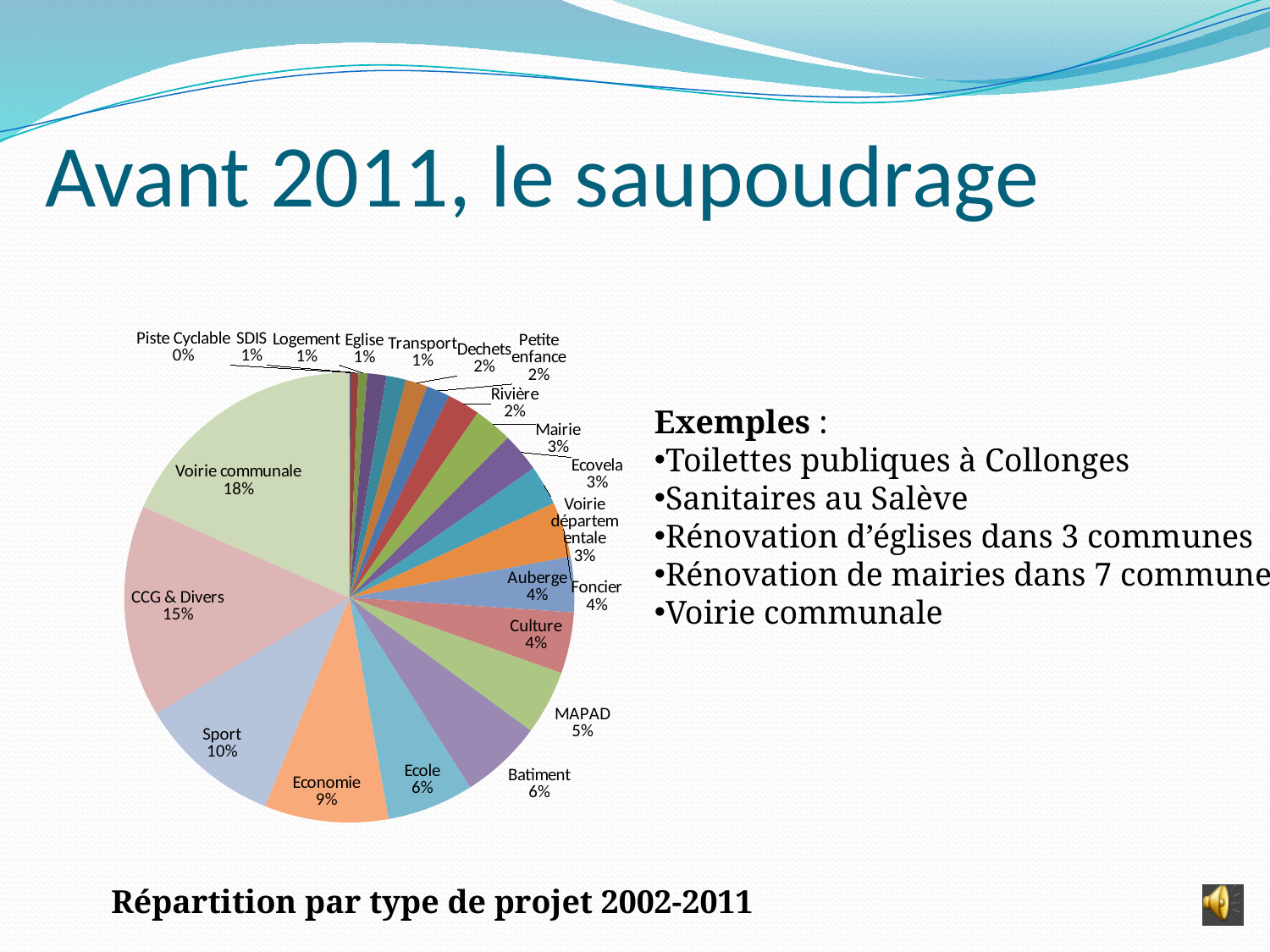
What percentage is shown for Sport? 10% What is the difference in percentage points between Voirie communale and CCG & Divers? 3 What percentage is shown for Economie? 9% What share of the pie does Voirie communale represent? 18% How many categories are shown in the pie chart? 21 Which is larger, the share for Sport or the share for Economie? Sport What percentage is shown for CCG & Divers? 15% What percentage is shown for MAPAD? 5% Which category has the smallest share, shown as 0%? Piste Cyclable Which category has the largest slice of the pie? Voirie communale What is the caption/title given for the pie chart? Répartition par type de projet 2002-2011 What kind of chart is shown on the slide? pie chart